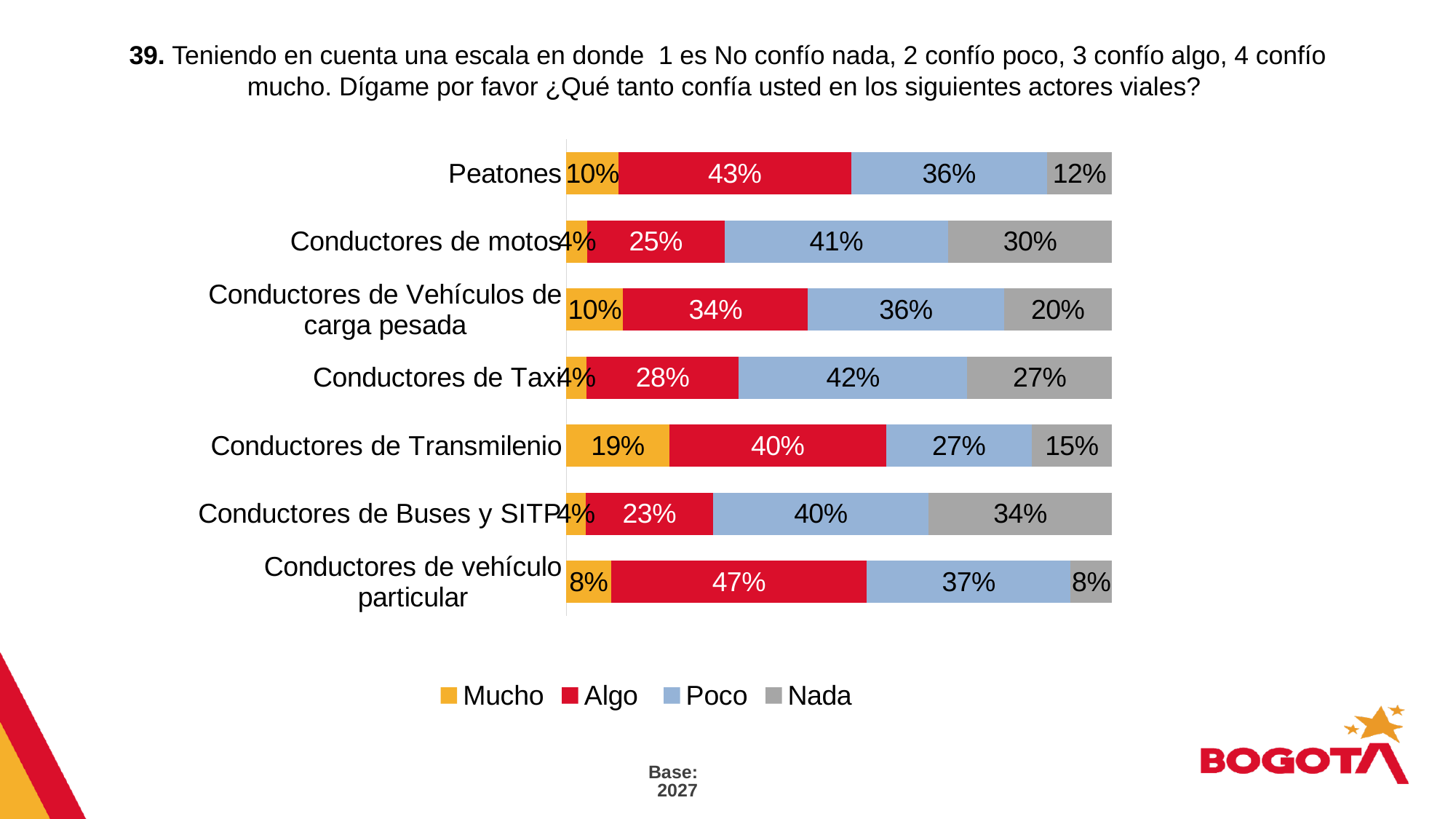
How many series does the legend list? 4 What is the difference between the "Nada" values for Conductores de motos and Peatones? 18% How many categories (road actors) are shown in the chart? 7 What is the "Mucho" value for Conductores de Transmilenio? 19% What is the "Nada" value for Conductores de Buses y SITP? 34% Which colour represents the "Nada" series in the legend? Grey Which is larger: the "Poco" value for Conductores de motos or the "Poco" value for Conductores de Transmilenio? Conductores de motos Which category has the lowest "Nada" value? Conductores de vehículo particular Which category has the highest "Algo" value? Conductores de vehículo particular What kind of chart is shown on the slide? Stacked bar chart What is the "Poco" value for Conductores de Taxi? 42% What percentage of respondents answered "Algo" for Peatones? 43%